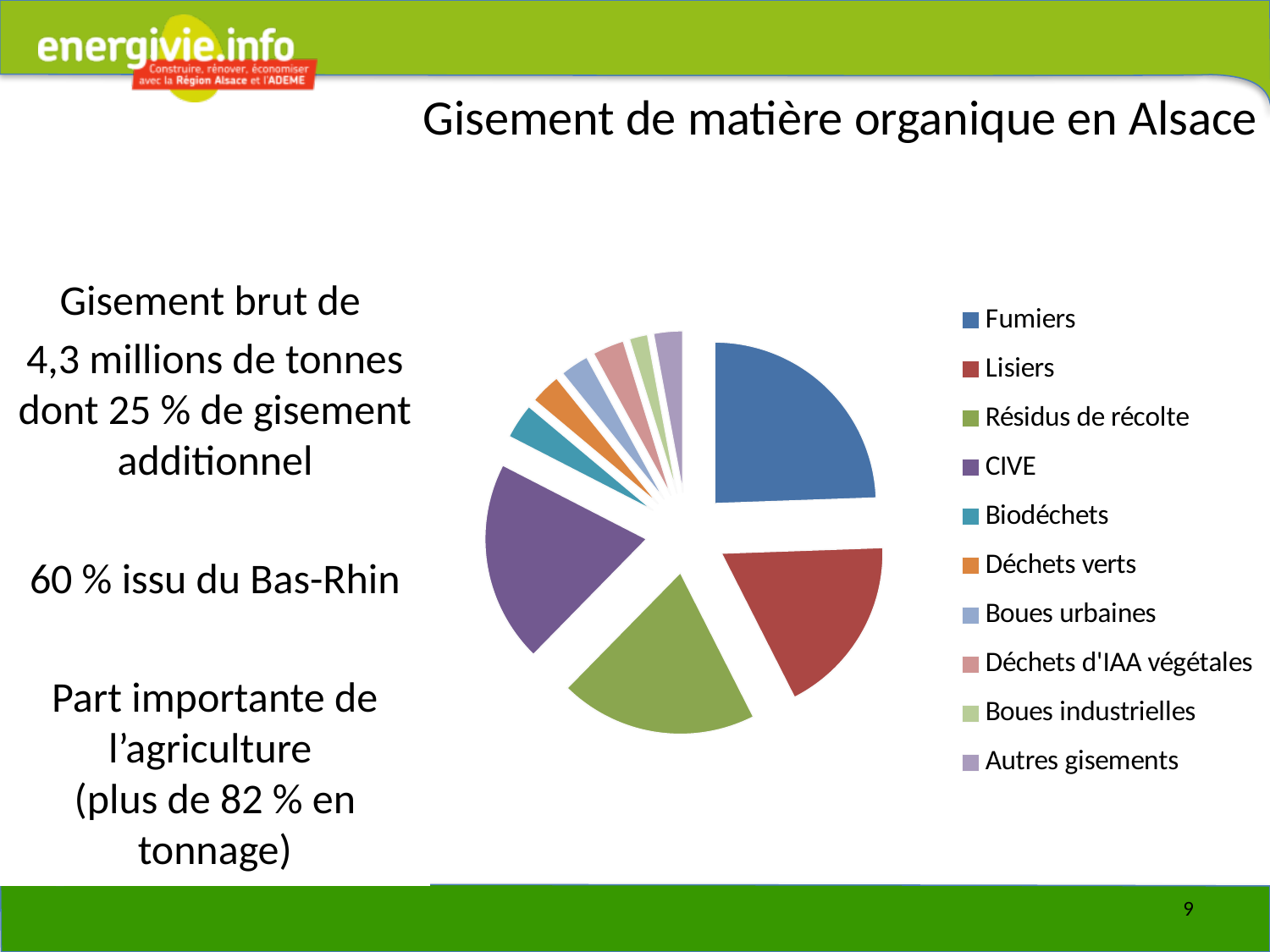
Which category has the largest slice of the pie chart? Fumiers What is the title of the slide containing the pie chart? Gisement de matière organique en Alsace Which slice is larger, Lisiers or Autres gisements? Lisiers What kind of chart is shown on the slide? pie chart How many categories does the pie chart's legend list? 10 Which slice is larger, Résidus de récolte or Déchets verts? Résidus de récolte What colour is the Fumiers slice in the pie chart? blue Which legend entry is listed last in the pie chart's legend? Autres gisements Which slice is larger, CIVE or Boues urbaines? CIVE